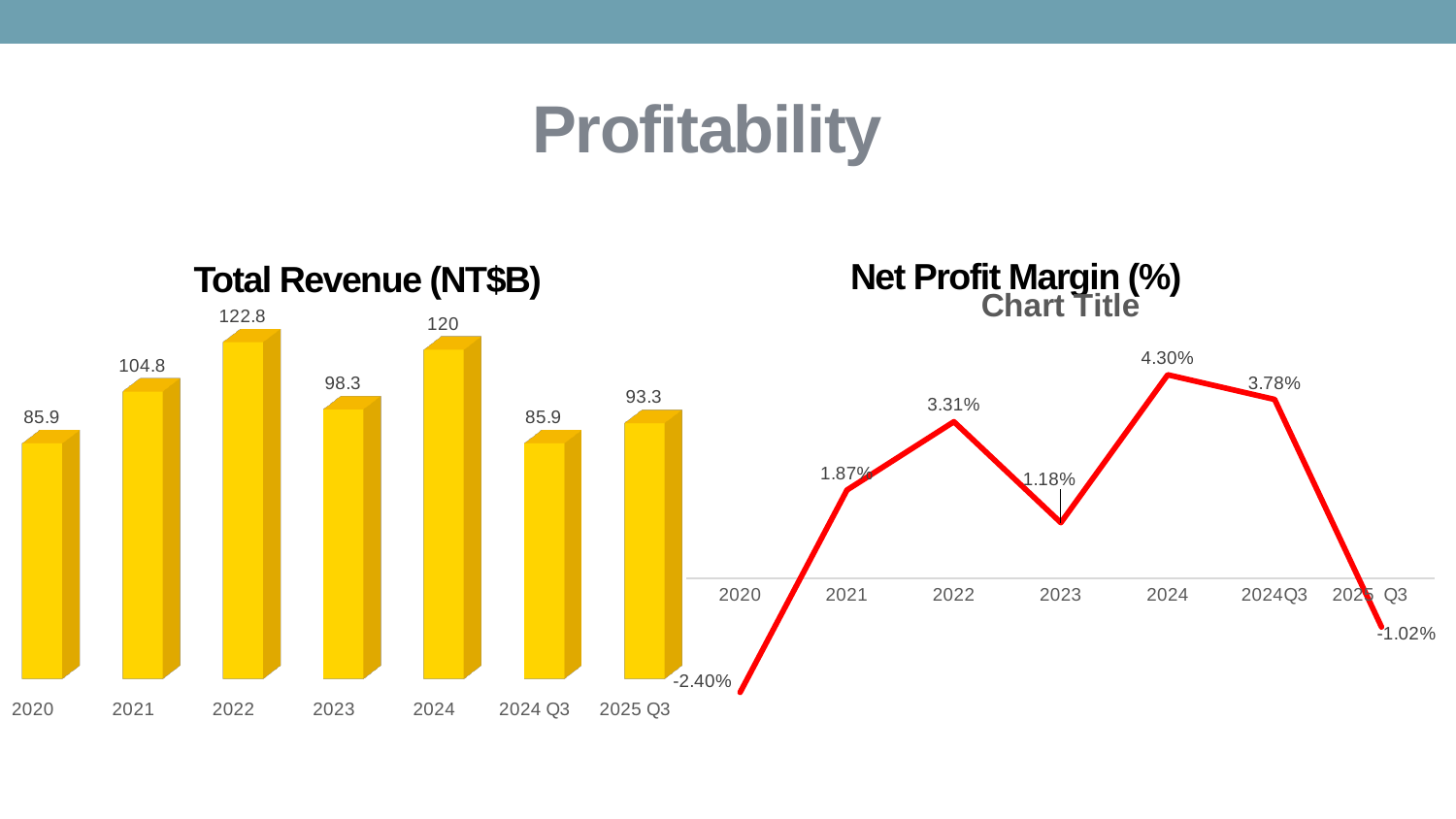
In the Total Revenue (NT$B) chart, what is the value for 2025 Q3? 93.3 In the Net Profit Margin (%) chart, which category has the lowest value? 2020 In the Total Revenue (NT$B) chart, which category has the highest value? 2022 What kind of chart is the Total Revenue (NT$B) chart? Bar chart How many categories are shown in the Total Revenue (NT$B) chart? 7 In the Total Revenue (NT$B) chart, what is the difference between the values for 2022 and 2023? 24.5 In the Net Profit Margin (%) chart, does the value rise or fall from 2024 to 2025 Q3? Fall In the Total Revenue (NT$B) chart, what is the value for 2022? 122.8 What kind of chart is the Net Profit Margin (%) chart? Line chart In the Total Revenue (NT$B) chart, which is larger, the value for 2021 or the value for 2023? 2021 In the Net Profit Margin (%) chart, what is the value for 2020? -2.40% In the Net Profit Margin (%) chart, what is the value for 2024? 4.30%